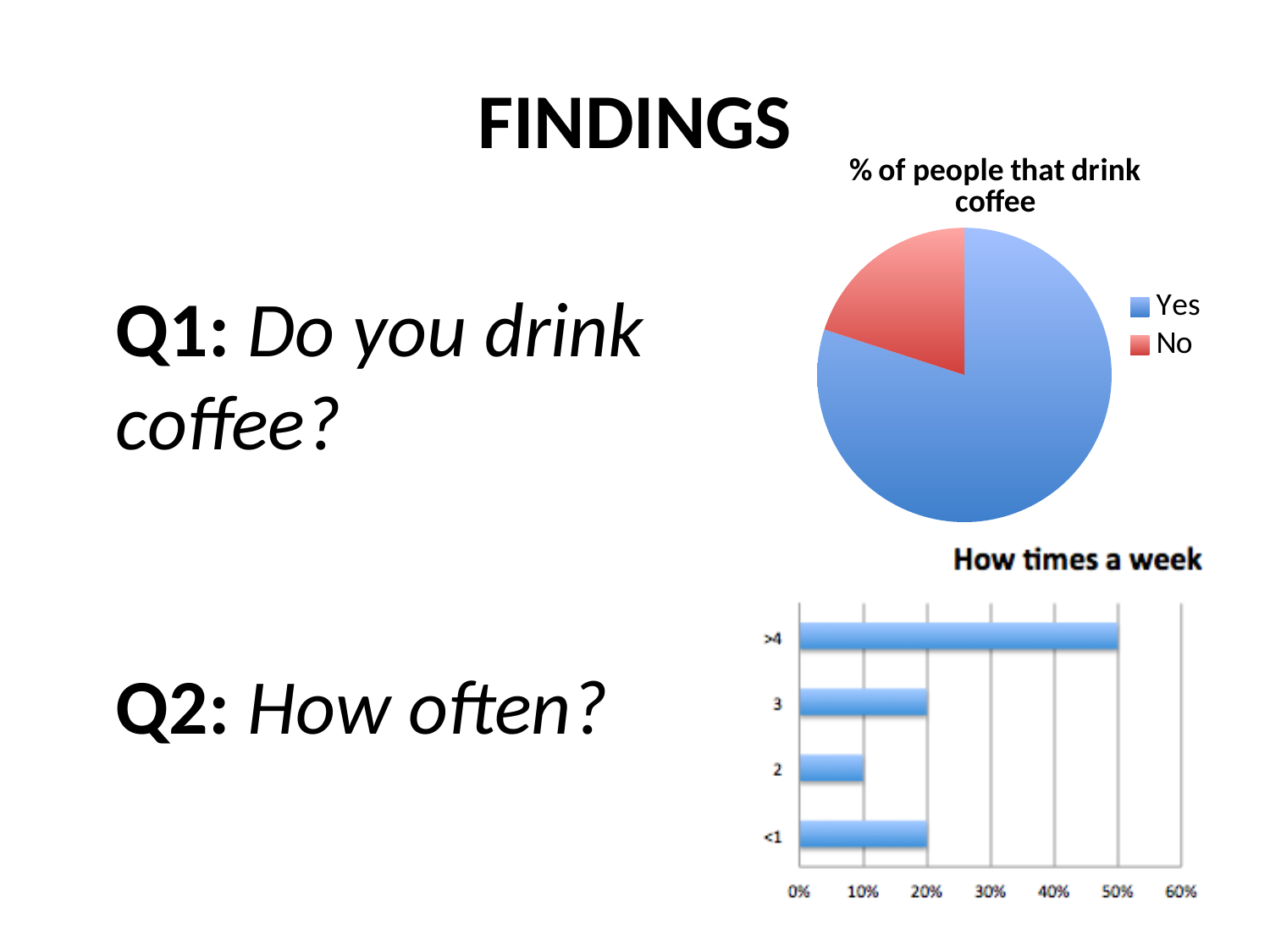
How many categories are shown in the 'How times a week' chart? 4 How many entries does the legend of the '% of people that drink coffee' chart list? 2 In the 'How times a week' chart, which category has the lowest value? 2 In the 'How times a week' chart, what is the value for '>4'? 50% In the 'How times a week' chart, what is the value for '<1'? 20% In the 'How times a week' chart, what is the difference between the values for '>4' and '3'? 30% In the 'How times a week' chart, which category has the highest value? >4 In the 'How times a week' chart, what is the value for '2'? 10% In the '% of people that drink coffee' chart, what colour is the 'No' slice? red What type of chart is the '% of people that drink coffee' chart? pie chart What type of chart is the 'How times a week' chart? bar chart In the '% of people that drink coffee' chart, which slice is larger, Yes or No? Yes